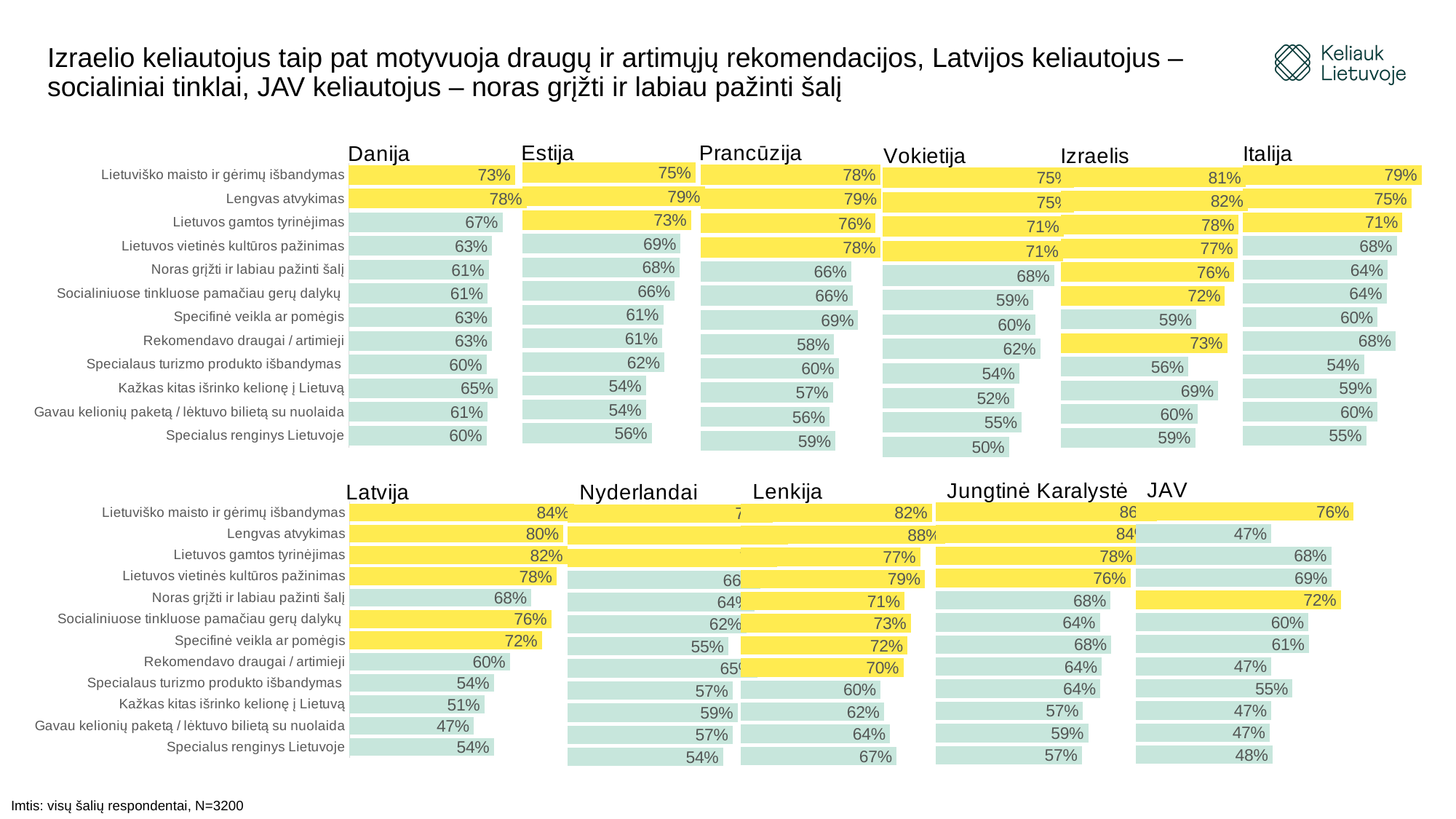
What type of chart is used for each country on the slide? Bar chart In the Izraelis chart, which category has the highest value? Lengvas atvykimas In the Prancūzija chart, what is the value for Specifinė veikla ar pomėgis? 69% In the Latvija chart, what is the value for Socialiniuose tinkluose pamačiau gerų dalykų? 76% In the Latvija chart, which category has the highest value? Lietuviško maisto ir gėrimų išbandymas For Lietuvos gamtos tyrinėjimas, which chart shows the larger value: Lenkija or Italija? Lenkija How many categories are listed in the Danija chart? 12 In the Izraelis chart, what is the value for Rekomendavo draugai / artimieji? 73% In the JAV chart, what is the value for Noras grįžti ir labiau pažinti šalį? 72% In the Danija chart, what is the difference between Lengvas atvykimas and Specialus renginys Lietuvoje? 18 percentage points In the Vokietija chart, which category has the lowest value? Specialus renginys Lietuvoje How many country charts are shown on the slide? 11